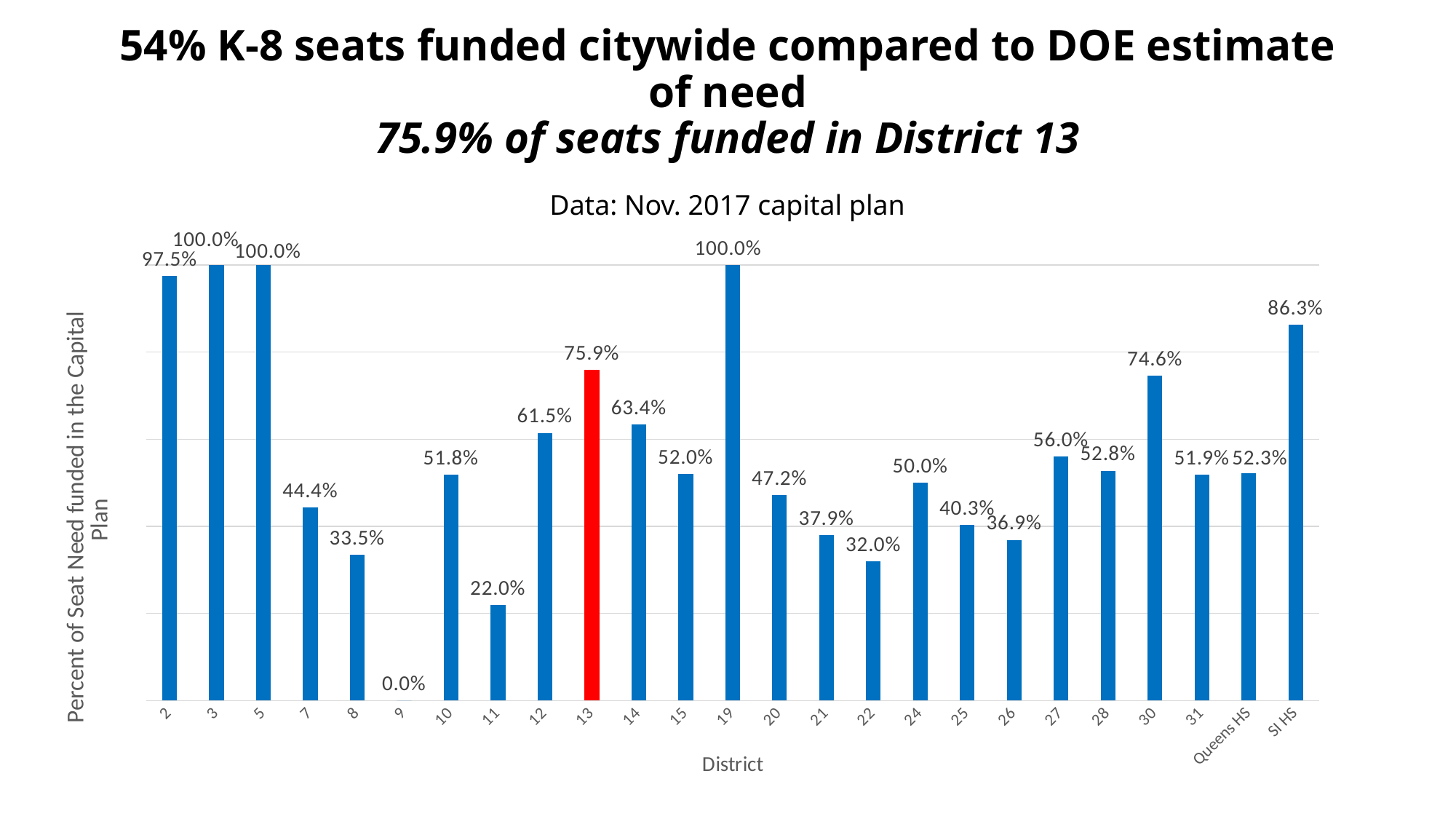
Which bar is highlighted in red? District 13 How many districts or categories are shown on the x axis? 25 What is the value shown for SI HS? 86.3% Which district has the lowest percent of seat need funded? 9 What is the difference between the values for District 12 and District 14? 1.9% What is the highest value shown on the chart? 100.0% What percent of seat need is funded for District 11? 22.0% What is the difference between the values for District 13 and District 30? 1.3% Which has a higher value, District 7 or District 8? District 7 What percent of seat need is funded in the capital plan for District 13? 75.9% What type of chart is shown on the slide? Bar chart What is the value shown for Queens HS? 52.3%